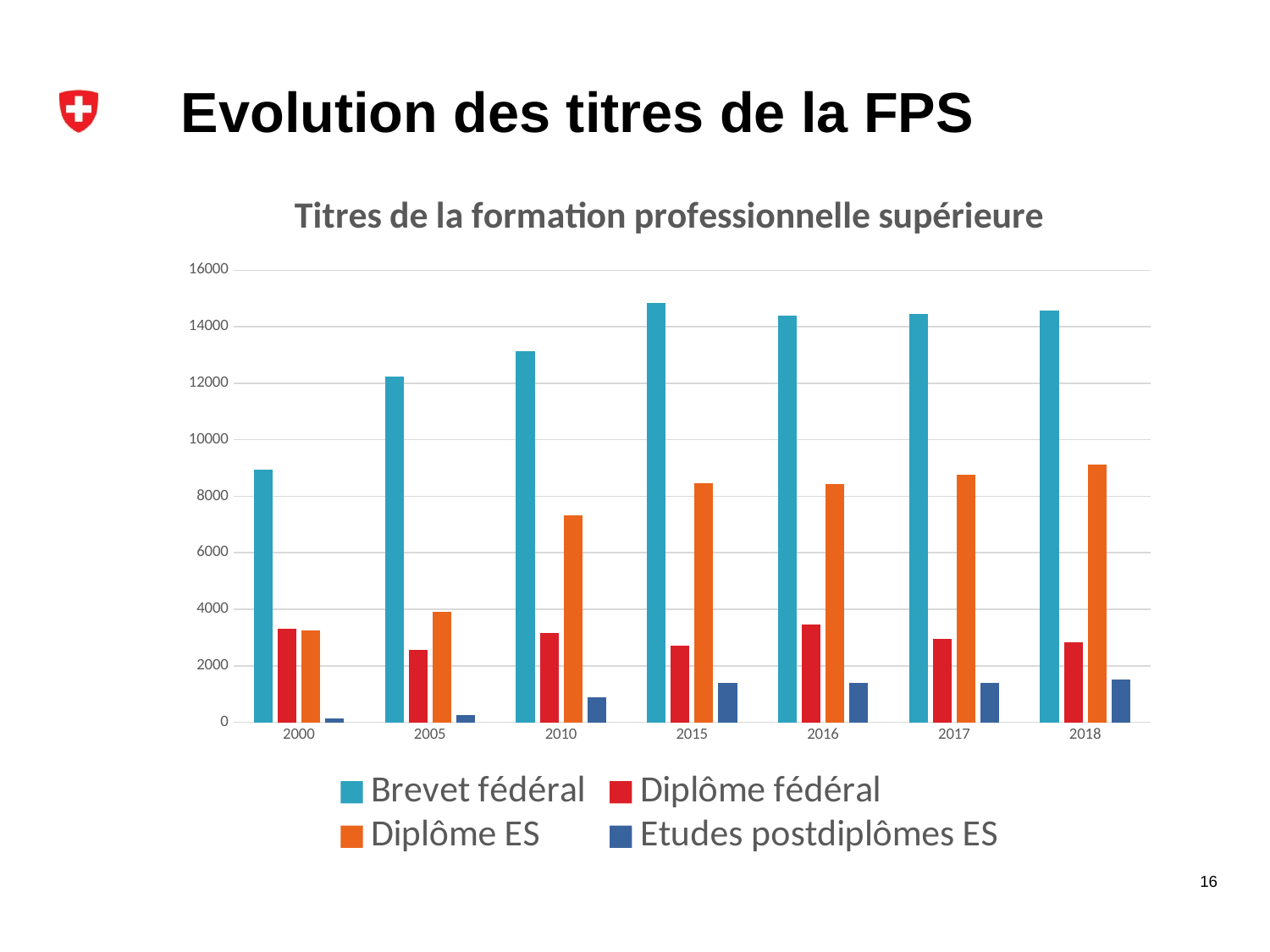
In which year is the Brevet fédéral value highest? 2015 In which year is the Etudes postdiplômes ES value lowest? 2000 In 2010, which is larger: Diplôme ES or Diplôme fédéral? Diplôme ES What kind of chart is shown on the slide? Bar chart What is the title of the chart? Titres de la formation professionnelle supérieure Is the value for Diplôme ES in 2018 greater or less than 8000? greater In which year is the Diplôme ES value highest? 2018 Is the value for Brevet fédéral in 2000 greater or less than 10000? less Is the value for Diplôme fédéral in 2016 greater or less than 4000? less Do the Diplôme ES values rise or fall from 2000 to 2018? rise How many series does the legend list? 4 How many years are shown on the x axis? 7